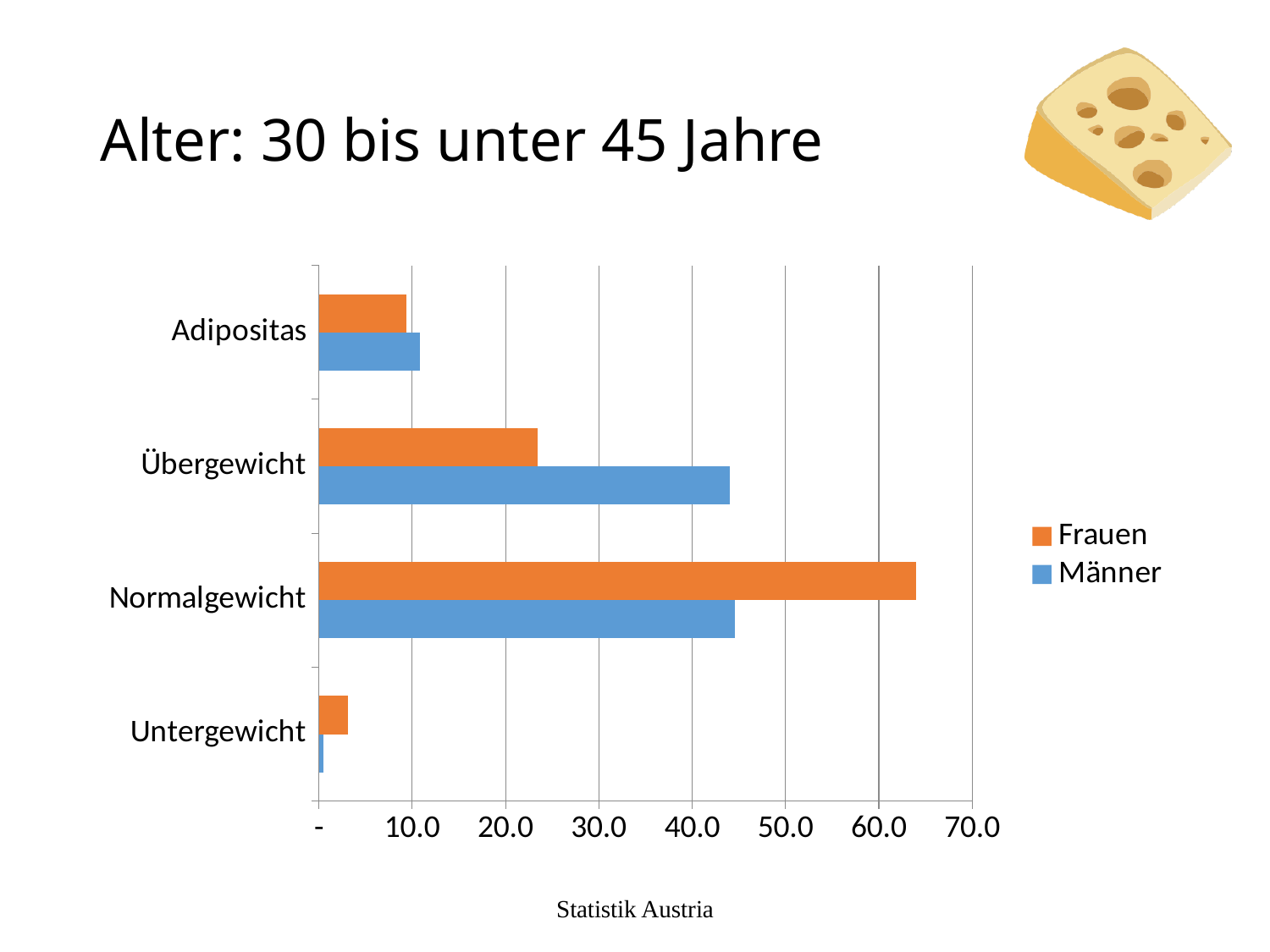
Is the value for Frauen in Untergewicht greater or less than 10.0? less What kind of chart is shown on the slide? bar chart How many categories are shown on the vertical axis? 4 Is the value for Frauen in Normalgewicht greater or less than 60.0? greater How many series does the legend list? 2 For Übergewicht, which is larger: the value for Frauen or for Männer? Männer Which category has the highest value for Frauen? Normalgewicht Which category has the lowest value for Männer? Untergewicht Is the value for Männer in Übergewicht greater or less than 40.0? greater Which category has the lowest value for Frauen? Untergewicht What is the title of the slide containing the chart? Alter: 30 bis unter 45 Jahre